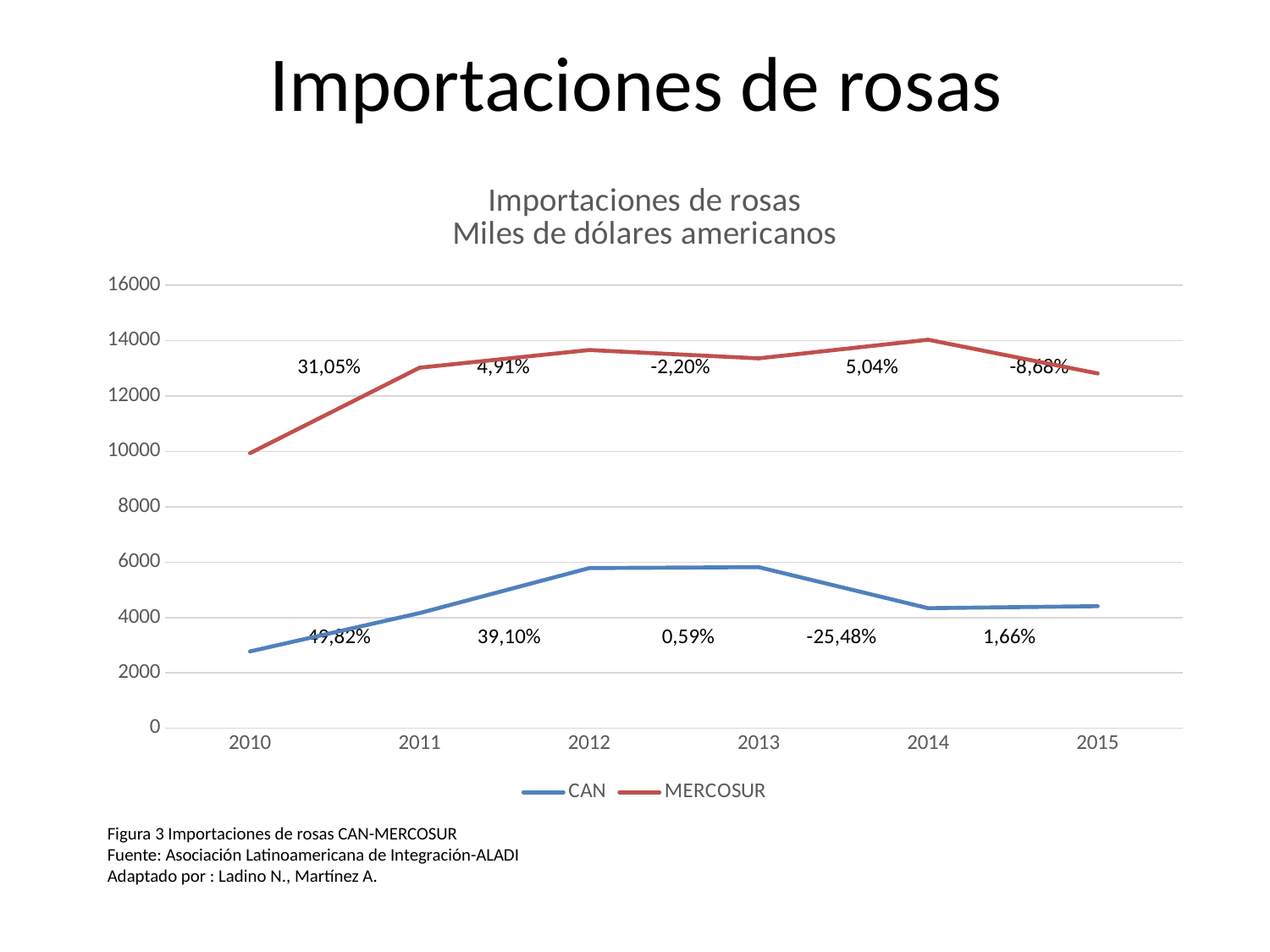
How many series does the legend list? 2 How many years are shown on the x axis? 6 Does the CAN series rise or fall from 2010 to 2012? rise Which series has the larger value in 2013, CAN or MERCOSUR? MERCOSUR What unit is stated in the chart's subtitle? Miles de dólares americanos In which year does the MERCOSUR series reach its highest value? 2014 In which year is the MERCOSUR series at its lowest value? 2010 What percentage change is printed for MERCOSUR between 2010 and 2011? 31,05% Is the value for MERCOSUR in 2012 greater or less than 12000? greater Is the value for CAN in 2012 greater or less than 6000? less In which year is the CAN series at its lowest value? 2010 What kind of chart is shown on the slide? line chart